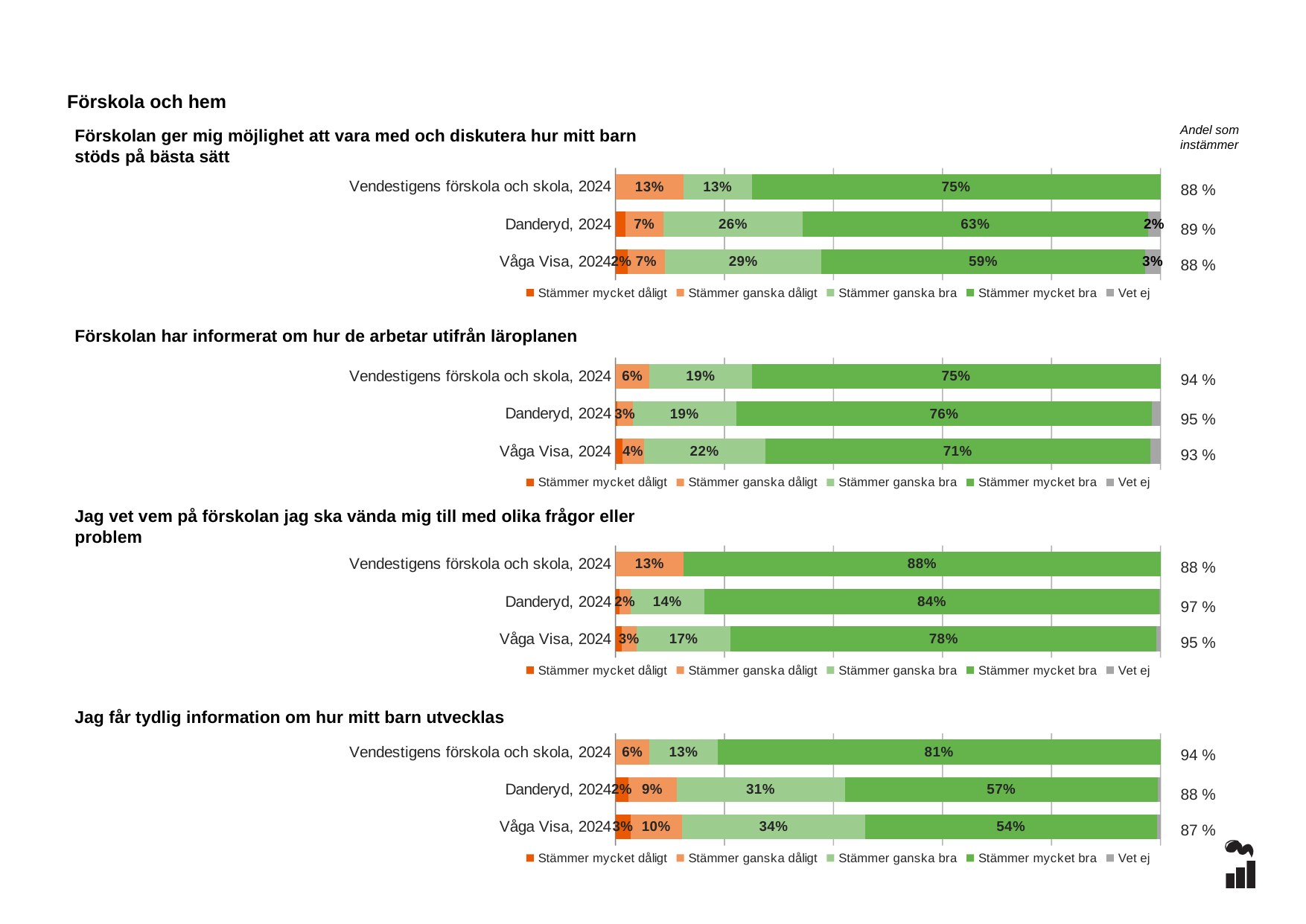
In the chart 'Förskolan ger mig möjlighet att vara med och diskutera hur mitt barn stöds på bästa sätt', what is the 'Stämmer mycket bra' value for Vendestigens förskola och skola, 2024? 75% In the chart 'Förskolan har informerat om hur de arbetar utifrån läroplanen', what is the 'Andel som instämmer' for Våga Visa, 2024? 93 % In the chart 'Jag vet vem på förskolan jag ska vända mig till med olika frågor eller problem', what is the 'Stämmer mycket bra' value for Vendestigens förskola och skola, 2024? 88% In the chart 'Förskolan ger mig möjlighet att vara med och diskutera hur mitt barn stöds på bästa sätt', what is the 'Stämmer ganska bra' value for Danderyd, 2024? 26% In the chart 'Jag får tydlig information om hur mitt barn utvecklas', which row has the lowest 'Stämmer mycket bra' value? Våga Visa, 2024 In the chart 'Jag vet vem på förskolan jag ska vända mig till med olika frågor eller problem', what is the difference between the 'Stämmer mycket bra' values for Danderyd, 2024 and Våga Visa, 2024? 6% How many series does the legend list for the chart 'Jag får tydlig information om hur mitt barn utvecklas'? 5 In the chart 'Jag vet vem på förskolan jag ska vända mig till med olika frågor eller problem', which row has the highest 'Andel som instämmer'? Danderyd, 2024 In the chart 'Jag får tydlig information om hur mitt barn utvecklas', is the 'Stämmer ganska bra' value larger for Danderyd, 2024 or Våga Visa, 2024? Våga Visa, 2024 In the chart 'Förskolan har informerat om hur de arbetar utifrån läroplanen', which row has the highest 'Stämmer mycket bra' value? Danderyd, 2024 What kind of chart is 'Förskolan har informerat om hur de arbetar utifrån läroplanen'? Stacked bar chart In the chart 'Förskolan ger mig möjlighet att vara med och diskutera hur mitt barn stöds på bästa sätt', what is the 'Vet ej' value for Våga Visa, 2024? 3%